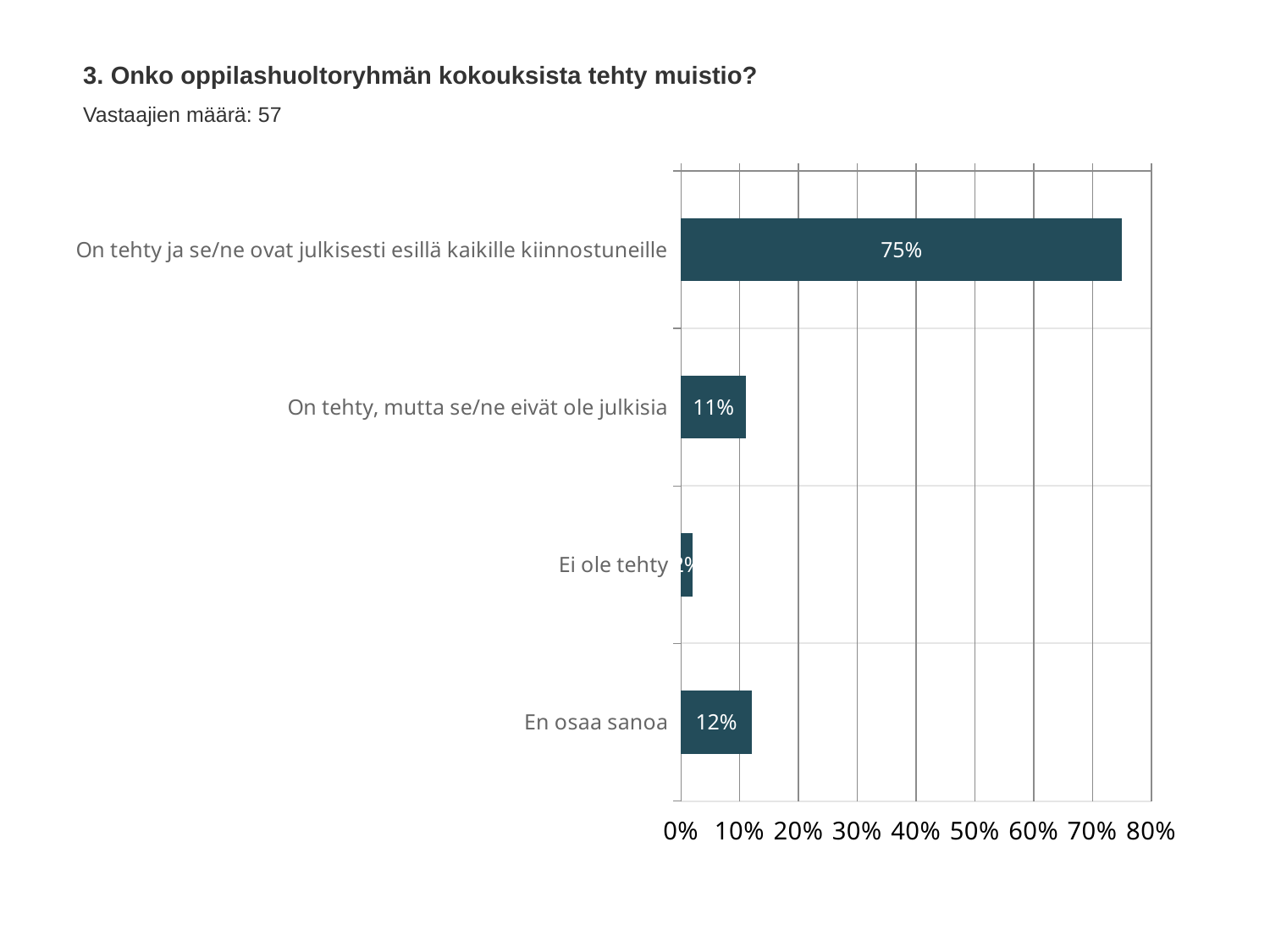
How many respondents (Vastaajien määrä) does the slide report? 57 How many categories are shown in the chart? 4 What is the value for "En osaa sanoa"? 12% Which category has the lowest value? Ei ole tehty What kind of chart is shown on the slide? Bar chart What is the difference between the values for "On tehty ja se/ne ovat julkisesti esillä kaikille kiinnostuneille" and "On tehty, mutta se/ne eivät ole julkisia"? 64 percentage points Is the value for "Ei ole tehty" greater or less than 10%? less What is the value for "On tehty ja se/ne ovat julkisesti esillä kaikille kiinnostuneille"? 75% Which category has the highest value? On tehty ja se/ne ovat julkisesti esillä kaikille kiinnostuneille Is the value for "On tehty ja se/ne ovat julkisesti esillä kaikille kiinnostuneille" greater or less than 70%? greater What is the value for "On tehty, mutta se/ne eivät ole julkisia"? 11% Which is larger, the value for "En osaa sanoa" or the value for "On tehty, mutta se/ne eivät ole julkisia"? En osaa sanoa